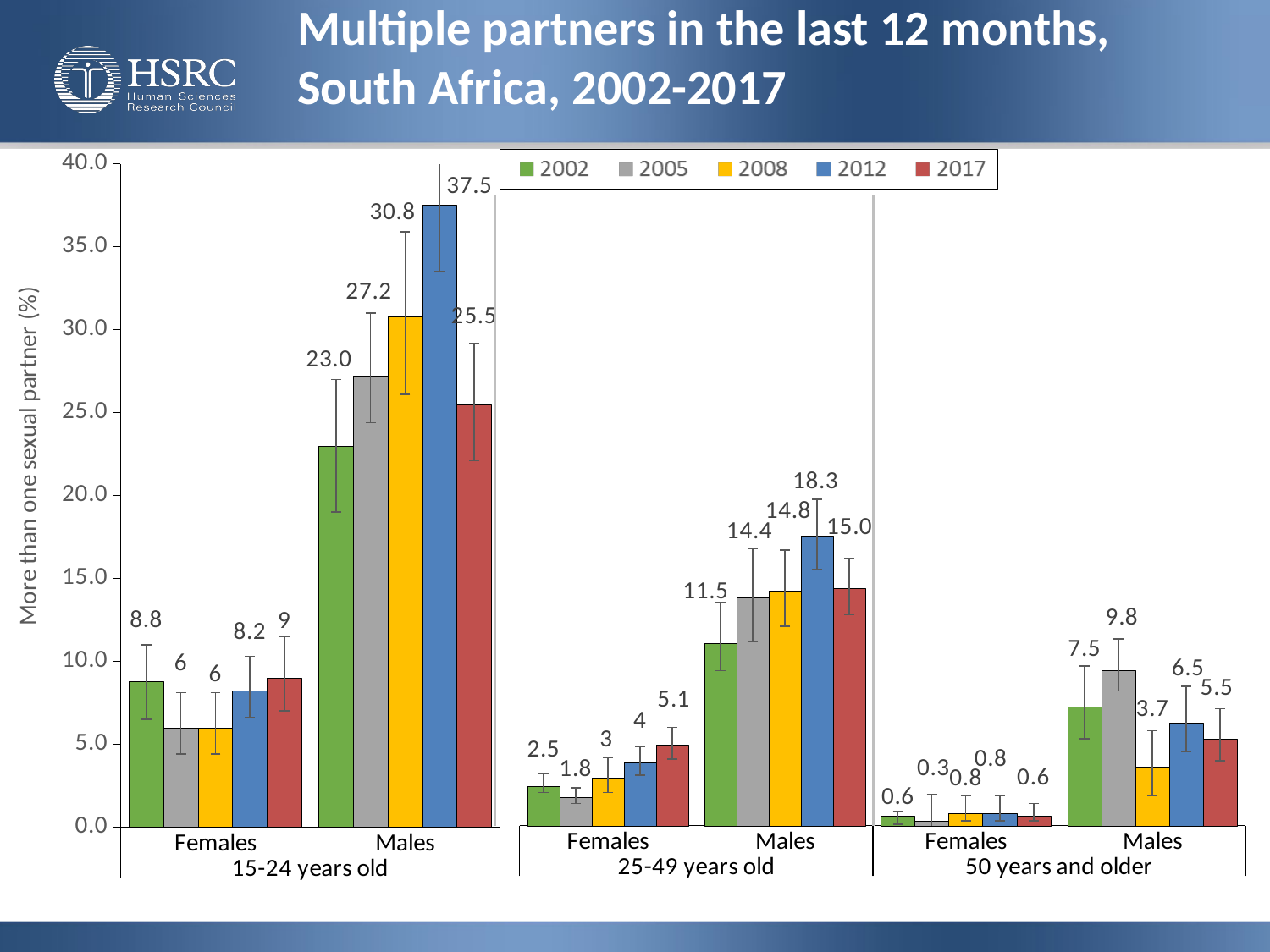
Which year has the lowest value for males aged 50 years and older? 2008 What kind of chart is shown on the slide? bar chart What is the value for males aged 15-24 in 2012? 37.5 Which year has the highest value for males aged 25-49? 2012 Do the values for females aged 25-49 rise or fall from 2005 to 2017? rise What is the difference between the 2012 and 2017 values for males aged 15-24? 12.0 Which is larger: the 2002 value for females aged 15-24 or the 2017 value for females aged 15-24? 2017 How many series does the legend list? 5 Is the value for males aged 15-24 in 2008 greater or less than 30.0? greater What is the label of the vertical axis? More than one sexual partner (%) What is the value for males aged 50 years and older in 2005? 9.8 What is the value for females aged 25-49 in 2017? 5.1